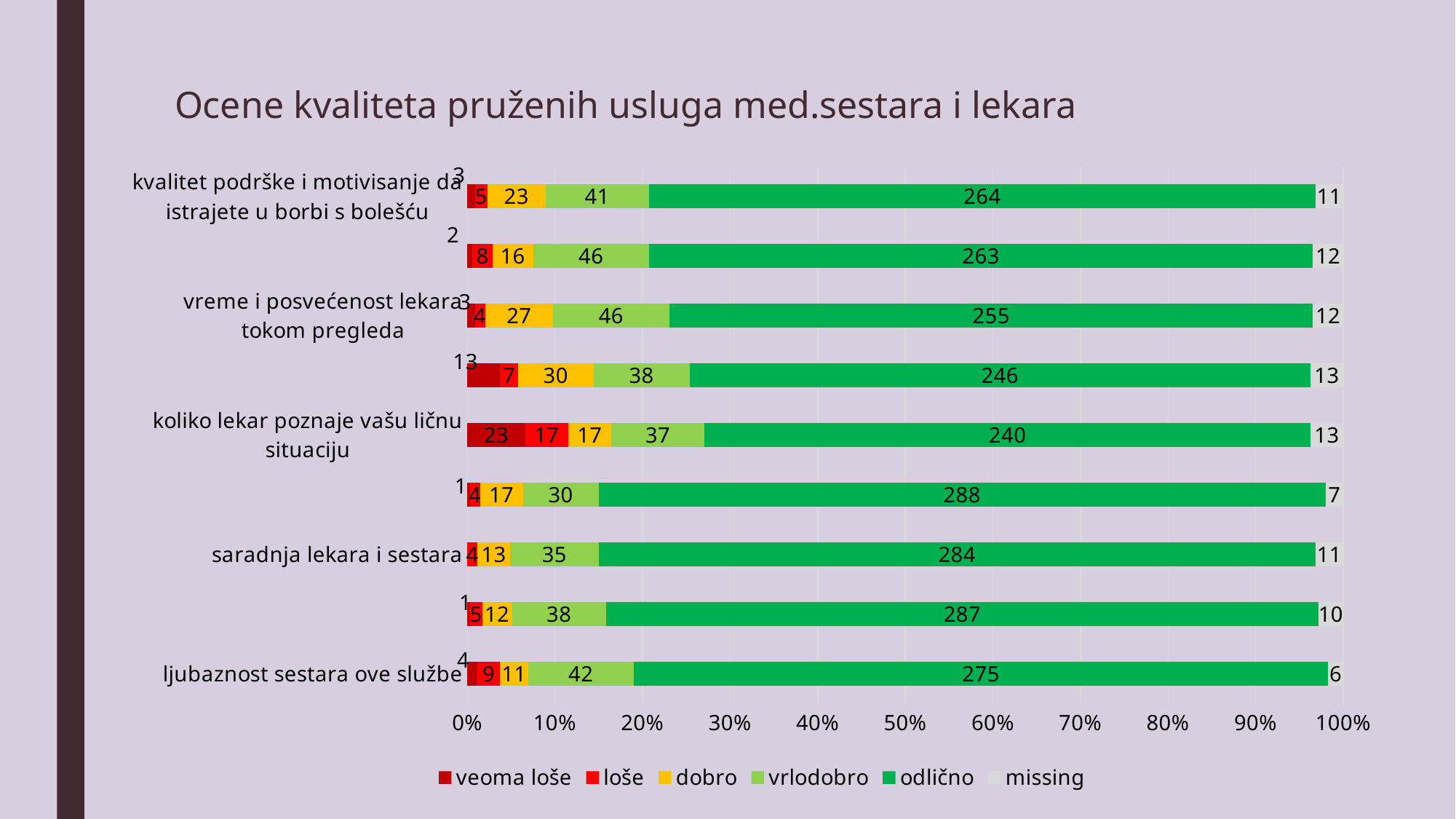
What is the total of all segments in the 'ljubaznost sestara ove službe' bar? 347 How many series does the legend list? 6 What is the difference between the 'odlično' values for 'saradnja lekara i sestara' and 'ljubaznost sestara ove službe'? 9 Which series has the largest segment in the 'koliko lekar poznaje vašu ličnu situaciju' bar? odlično What is the 'dobro' value for 'vreme i posvećenost lekara tokom pregleda'? 27 What is the 'odlično' value for 'koliko lekar poznaje vašu ličnu situaciju'? 240 What is the title of the chart? Ocene kvaliteta pruženih usluga med.sestara i lekara How many bars are plotted in the chart? 9 What kind of chart is shown on the slide? stacked bar chart What is the 'missing' value for 'ljubaznost sestara ove službe'? 6 What is the 'veoma loše' value for 'koliko lekar poznaje vašu ličnu situaciju'? 23 Which has the larger 'vrlodobro' value: 'kvalitet podrške i motivisanje da istrajete u borbi s bolešću' or 'vreme i posvećenost lekara tokom pregleda'? vreme i posvećenost lekara tokom pregleda